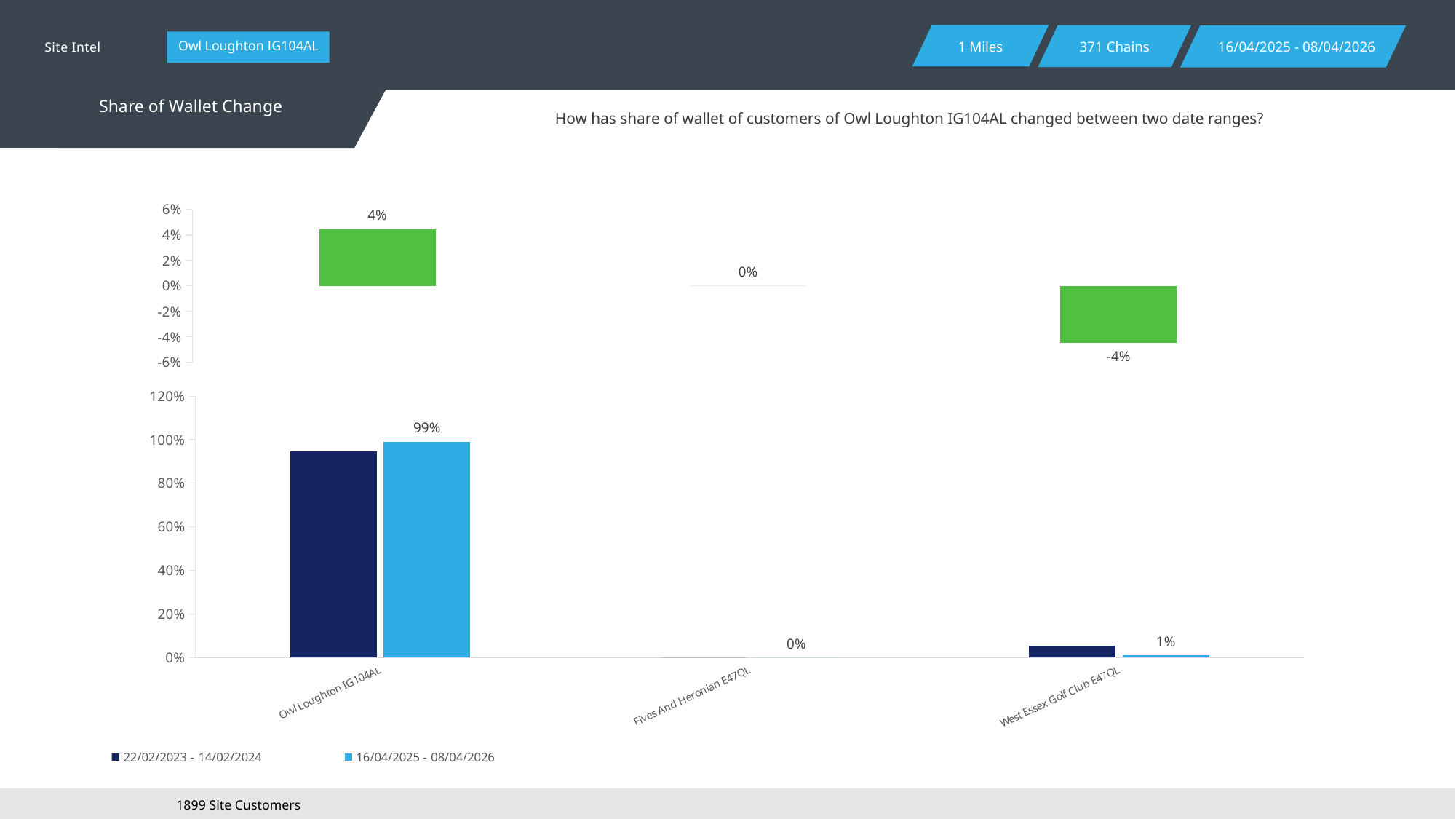
In the bottom chart, is the value for Owl Loughton IG104AL in the 22/02/2023 - 14/02/2024 period greater or less than 80%? greater In the bottom chart, is the value for West Essex Golf Club E47QL in the 22/02/2023 - 14/02/2024 period greater or less than 20%? less How many series does the legend of the bottom chart list? 2 In the top chart, which category has the lowest share of wallet change? West Essex Golf Club E47QL In the top chart, what is the share of wallet change for West Essex Golf Club E47QL? -4% In the bottom chart, what is the share of wallet for Owl Loughton IG104AL in the 16/04/2025 - 08/04/2026 period? 99% In the bottom chart, what is the share of wallet for West Essex Golf Club E47QL in the 16/04/2025 - 08/04/2026 period? 1% In the top chart, what is the share of wallet change for Owl Loughton IG104AL? 4% In the top chart, what is the difference between the change for Owl Loughton IG104AL and West Essex Golf Club E47QL? 8% In the top chart, what is the share of wallet change for Fives And Heronian E47QL? 0% What kind of chart is the bottom chart? Bar chart In the top chart, which category has the highest share of wallet change? Owl Loughton IG104AL